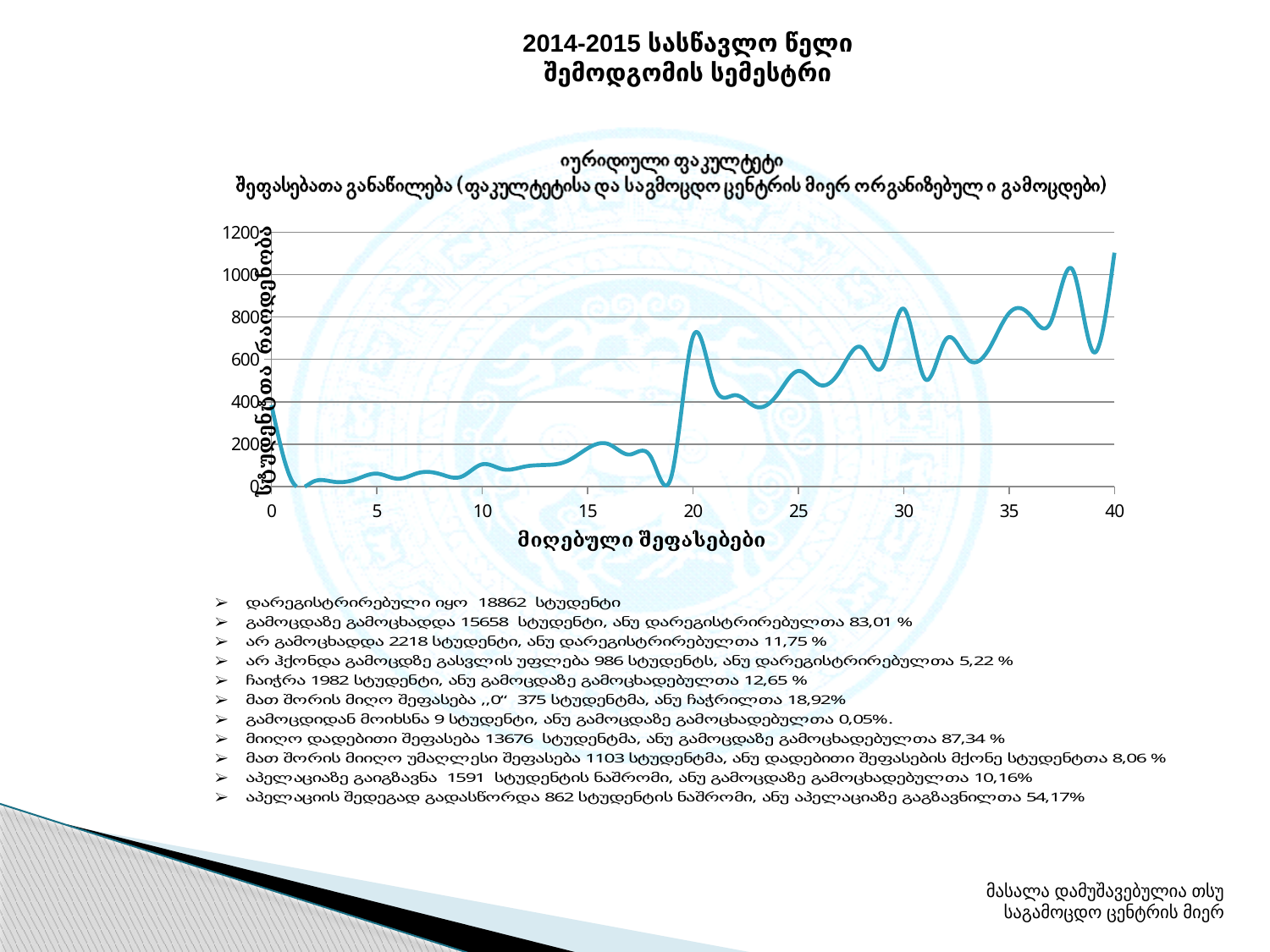
Is the value of the line at x = 35 greater or less than 600? greater Is the value of the line at x = 25 greater or less than 400? greater Is the value of the line at x = 40 larger or smaller than the value at x = 20? larger Is the value of the line at x = 5 greater or less than 200? less What is the label of the x axis of the chart? მიღებული შეფასებები Between x = 20 and x = 40, does the line generally rise or fall? rise What is the highest value shown on the y axis of the chart? 1200 What kind of chart is shown on the slide? line chart